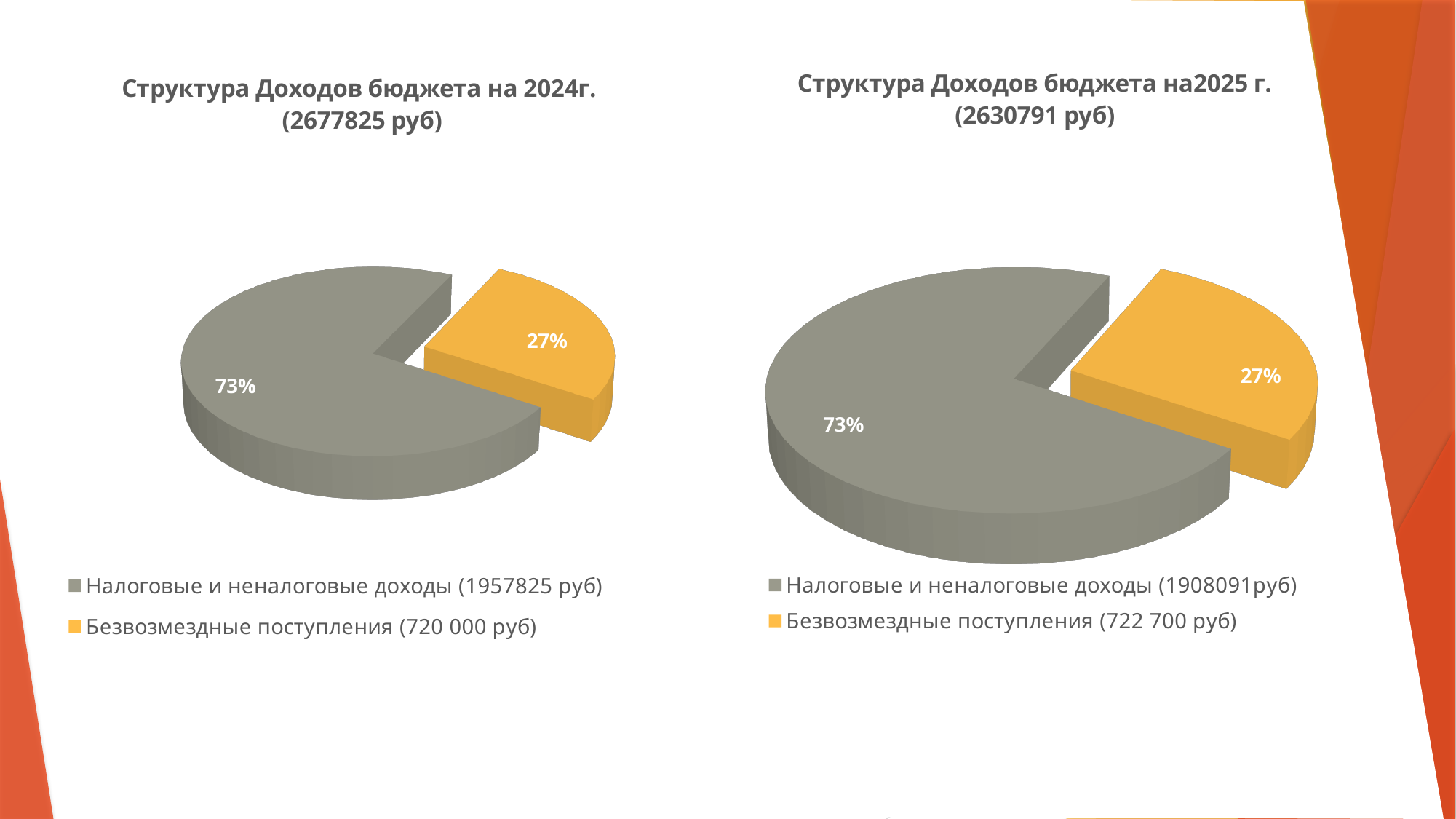
In the right chart (Структура Доходов бюджета на2025 г.), what share of the pie is Безвозмездные поступления? 27% In the left chart (Структура Доходов бюджета на 2024г.), which is larger: Налоговые и неналоговые доходы or Безвозмездные поступления? Налоговые и неналоговые доходы What kind of chart is the right chart (Структура Доходов бюджета на2025 г.)? Pie chart In the left chart (Структура Доходов бюджета на 2024г.), what is the difference in percentage points between the two slices? 46 In the left chart (Структура Доходов бюджета на 2024г.), what share of the pie is Безвозмездные поступления? 27% How many slices does the left chart (Структура Доходов бюджета на 2024г.) have? 2 In the right chart (Структура Доходов бюджета на2025 г.), what share of the pie is Налоговые и неналоговые доходы? 73% In the right chart (Структура Доходов бюджета на2025 г.), which category has the smallest slice? Безвозмездные поступления How many entries does the legend of the right chart (Структура Доходов бюджета на2025 г.) list? 2 In the left chart (Структура Доходов бюджета на 2024г.), which category has the largest slice? Налоговые и неналоговые доходы In the right chart (Структура Доходов бюджета на2025 г.), what colour is the Безвозмездные поступления slice? Orange